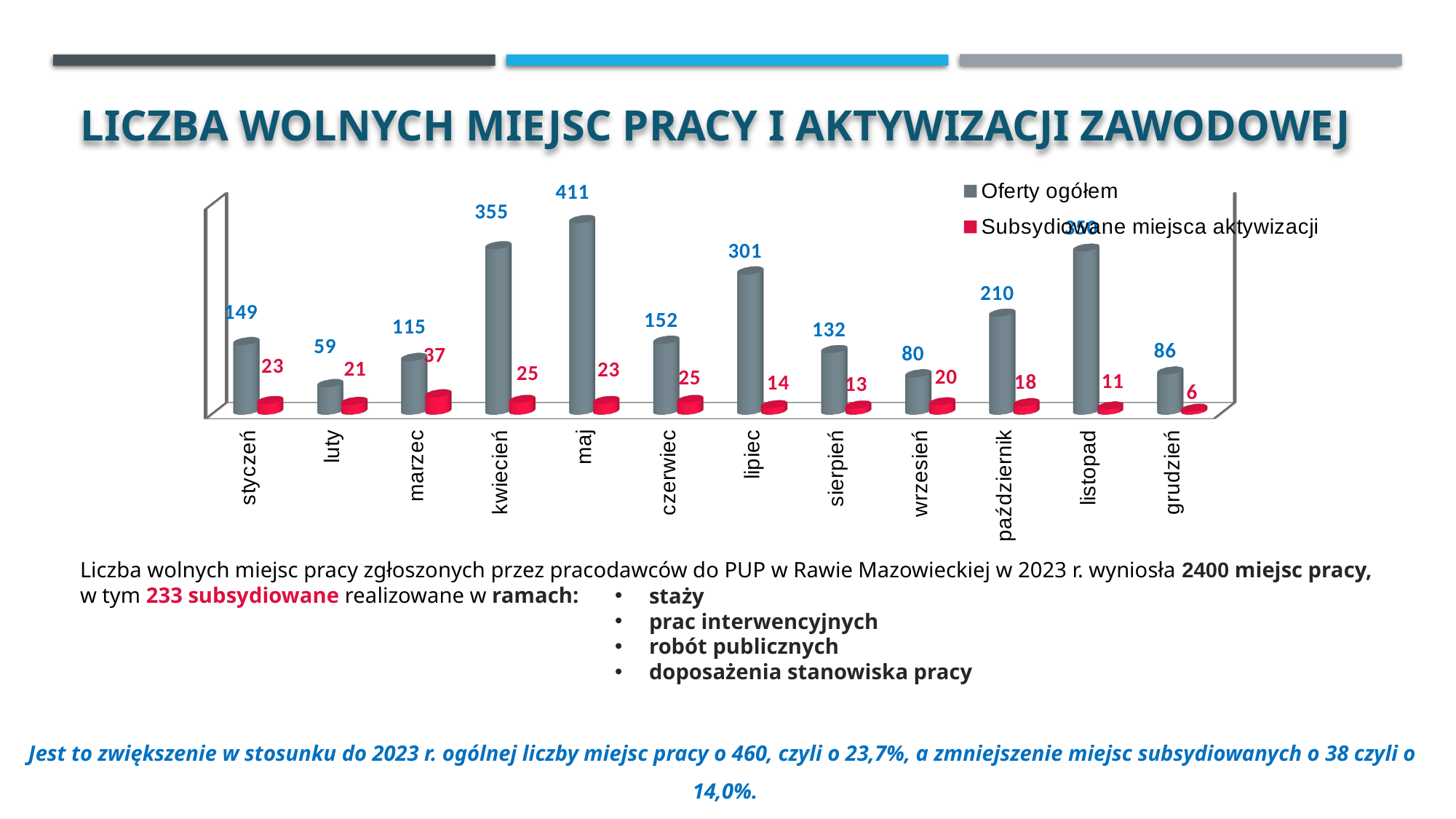
How many months are shown on the x axis of the chart? 12 Which month has a larger Oferty ogółem value, lipiec or październik? lipiec Which month has the lowest value for Oferty ogółem? luty How many series does the chart legend list? 2 Which month has the lowest value for Subsydiowane miejsca aktywizacji? grudzień What is the difference between the Oferty ogółem values for maj and kwiecień? 56 What is the value of Subsydiowane miejsca aktywizacji for marzec? 37 What is the value of Oferty ogółem for kwiecień? 355 What is the value of Oferty ogółem for wrzesień? 80 Which month has the highest value for Oferty ogółem? maj What type of chart is shown on the slide? bar chart Which month has the highest value for Subsydiowane miejsca aktywizacji? marzec